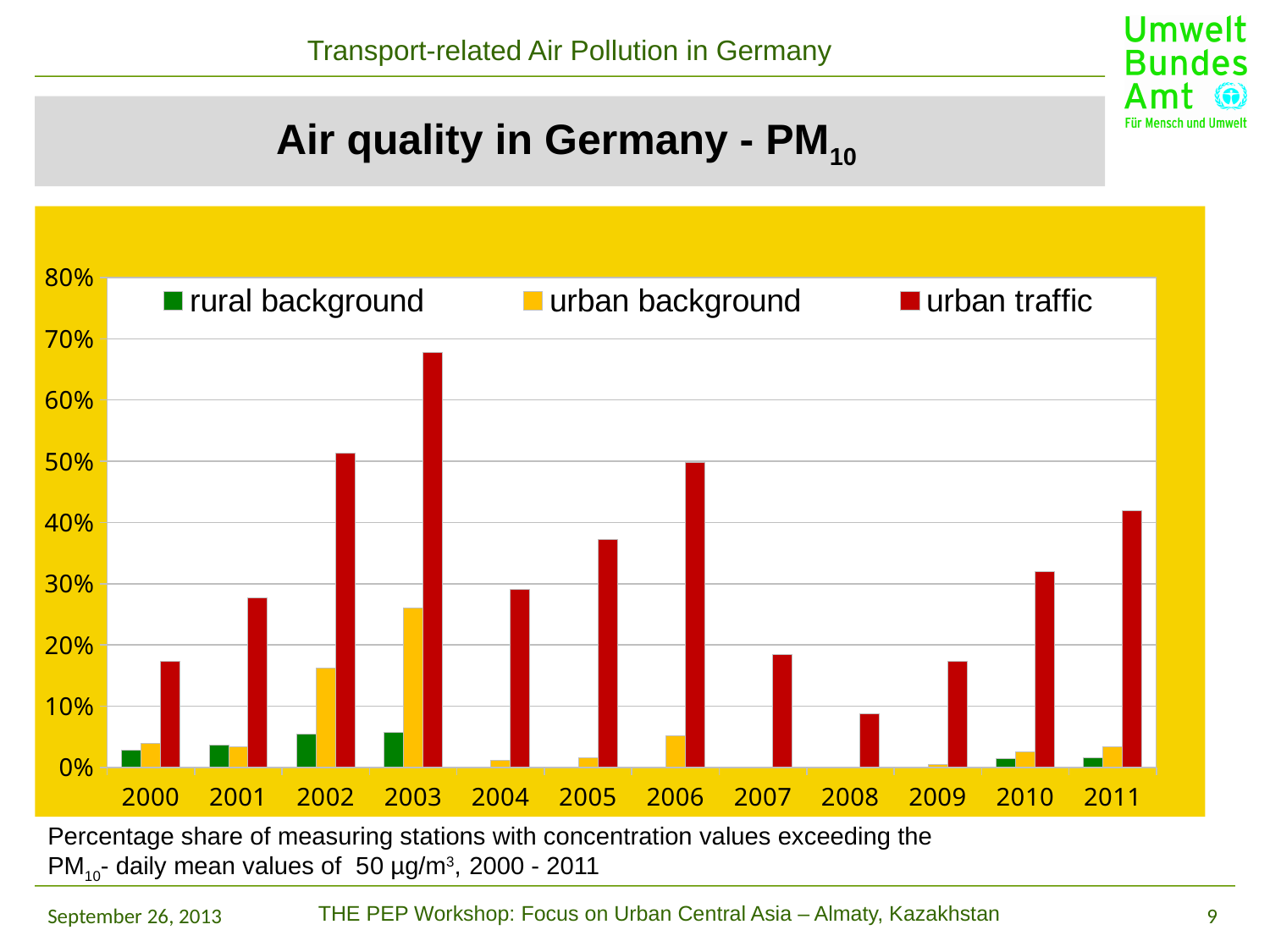
Do the urban traffic values rise or fall from 2008 to 2011? rise Is the urban traffic value for 2008 greater or less than 10%? less What colour represents the urban traffic series in the legend? red In which year is the urban background value highest? 2003 How many years are shown on the x axis? 12 Which year has the larger urban traffic value, 2005 or 2010? 2005 Is the urban background value for 2003 greater or less than 20%? greater What kind of chart is shown on the slide? bar chart Is the urban traffic value for 2003 greater or less than 60%? greater How many series does the legend list? 3 In which year is the urban traffic value lowest? 2008 In which year is the urban traffic value highest? 2003